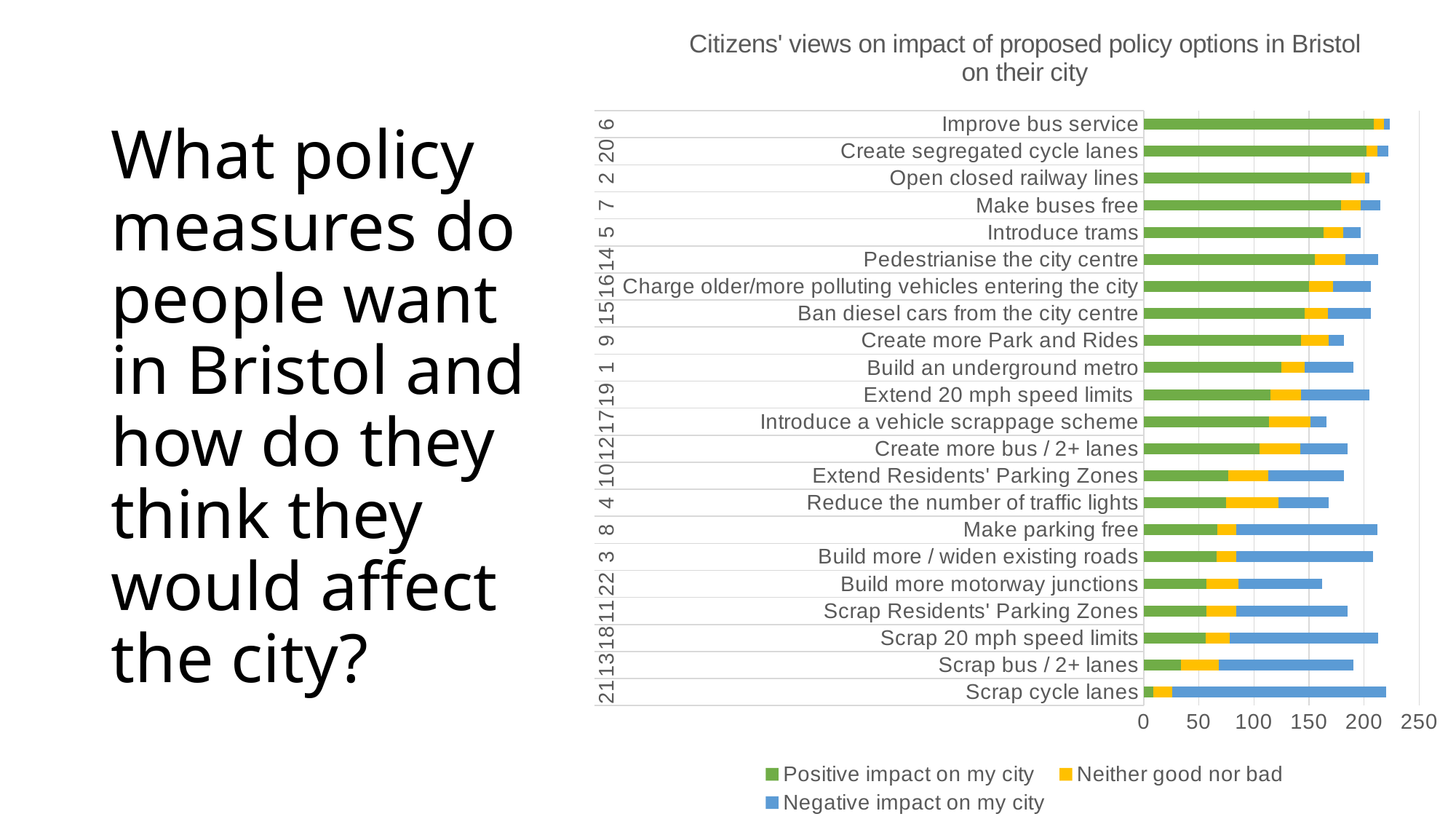
Is the 'Positive impact on my city' value for 'Improve bus service' greater or less than 200? greater Which has a larger 'Positive impact on my city' segment: 'Introduce trams' or 'Make parking free'? Introduce trams What kind of chart is shown on the slide? stacked bar chart Is the 'Positive impact on my city' value for 'Scrap cycle lanes' greater or less than 50? less Which policy option has the smallest 'Positive impact on my city' segment? Scrap cycle lanes Going down the list of policy options from top to bottom, do the 'Positive impact on my city' segments generally get longer or shorter? shorter Which colour represents 'Negative impact on my city' in the chart? blue Which policy option has the largest 'Negative impact on my city' segment? Scrap cycle lanes How many series does the legend list? 3 How many policy options are listed on the chart? 22 What is the title of the chart? Citizens' views on impact of proposed policy options in Bristol on their city Is the total bar length for 'Build more motorway junctions' greater or less than 200? less